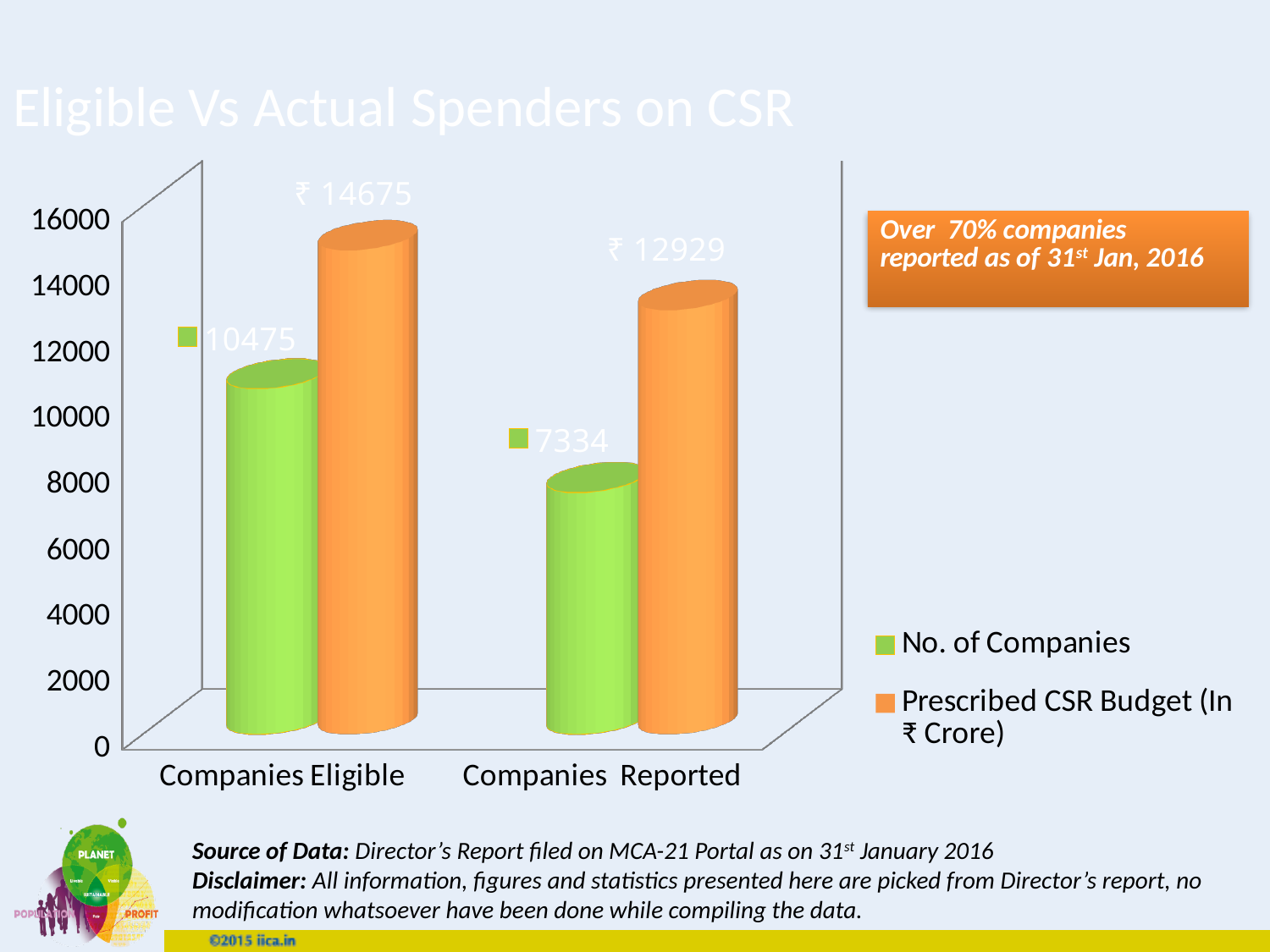
How many categories are shown on the x axis of the chart? 2 How many series does the chart legend list? 2 What is the difference in Prescribed CSR Budget (In ₹ Crore) between Companies Eligible and Companies Reported? ₹ 1746 What is the Prescribed CSR Budget (In ₹ Crore) for Companies Reported? ₹ 12929 Which category has the lower Prescribed CSR Budget (In ₹ Crore)? Companies Reported What type of chart is shown on the slide? Bar chart What is the No. of Companies value for Companies Eligible? 10475 For Companies Reported, which is larger: the No. of Companies or the Prescribed CSR Budget (In ₹ Crore)? Prescribed CSR Budget (In ₹ Crore) What is the No. of Companies value for Companies Reported? 7334 What is the difference in No. of Companies between Companies Eligible and Companies Reported? 3141 Which category has the higher No. of Companies? Companies Eligible What is the Prescribed CSR Budget (In ₹ Crore) for Companies Eligible? ₹ 14675